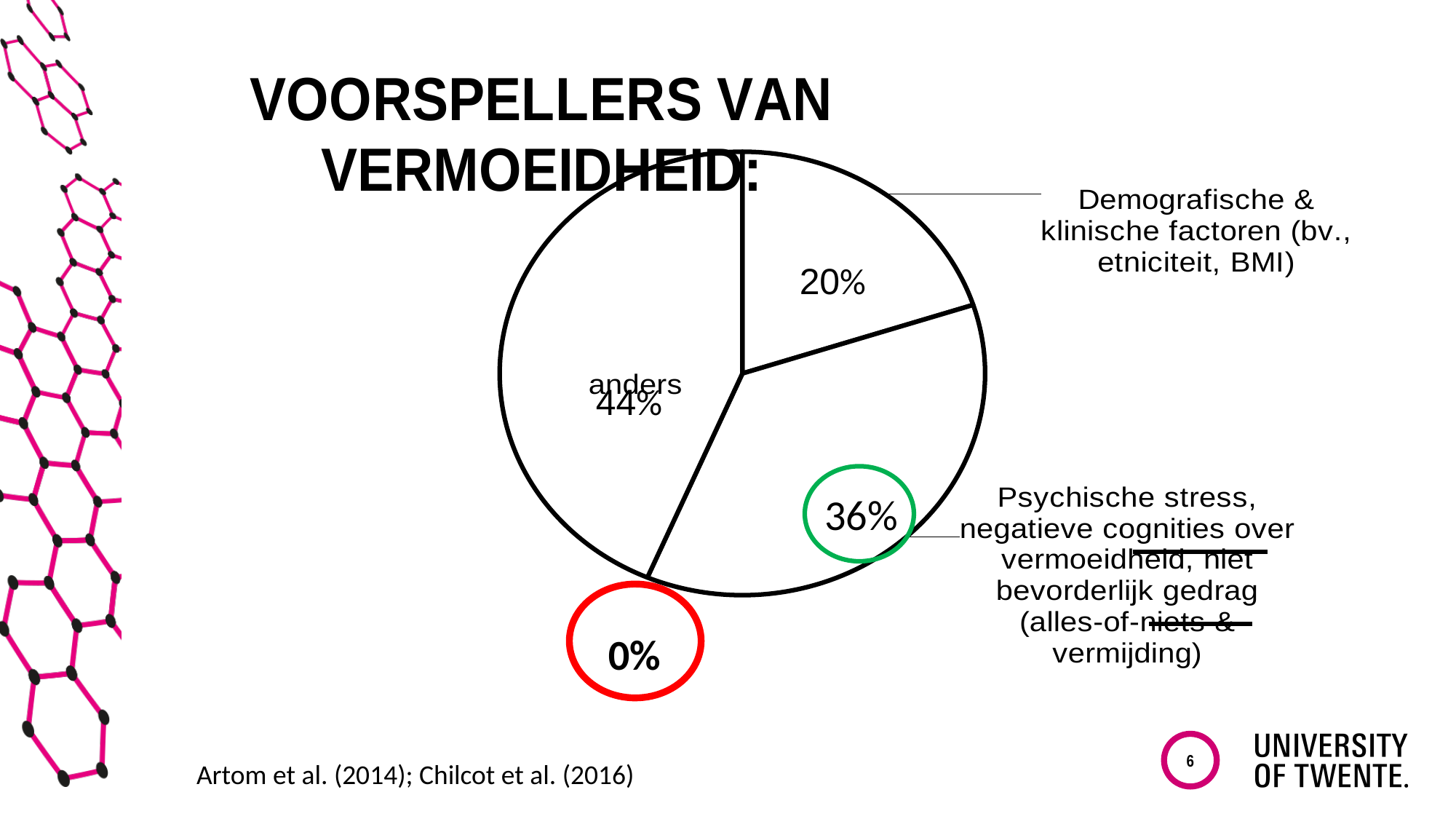
What share of the pie is labelled 'Demografische & klinische factoren (bv., etniciteit, BMI)'? 20% How many percentage points larger is the 'Psychische stress' slice than the 'Demografische & klinische factoren' slice? 16 Which slice of the pie has the largest share? anders What share of the pie is labelled 'Psychische stress, negatieve cognities over vermoeidheid, niet bevorderlijk gedrag'? 36% Is the share for 'anders' greater or less than 40%? greater Which is larger: the 'Psychische stress' slice or the 'Demografische & klinische factoren' slice? Psychische stress What kind of chart is shown on the slide? pie chart What share of the pie is labelled 'anders'? 44% Of the three named categories, which has the smallest share? Demografische & klinische factoren How many percentage points larger is the 'anders' slice than the 'Psychische stress' slice? 8 Which percentage value is circled in red below the pie chart? 0% What is the title of the slide containing the pie chart? VOORSPELLERS VAN VERMOEIDHEID: